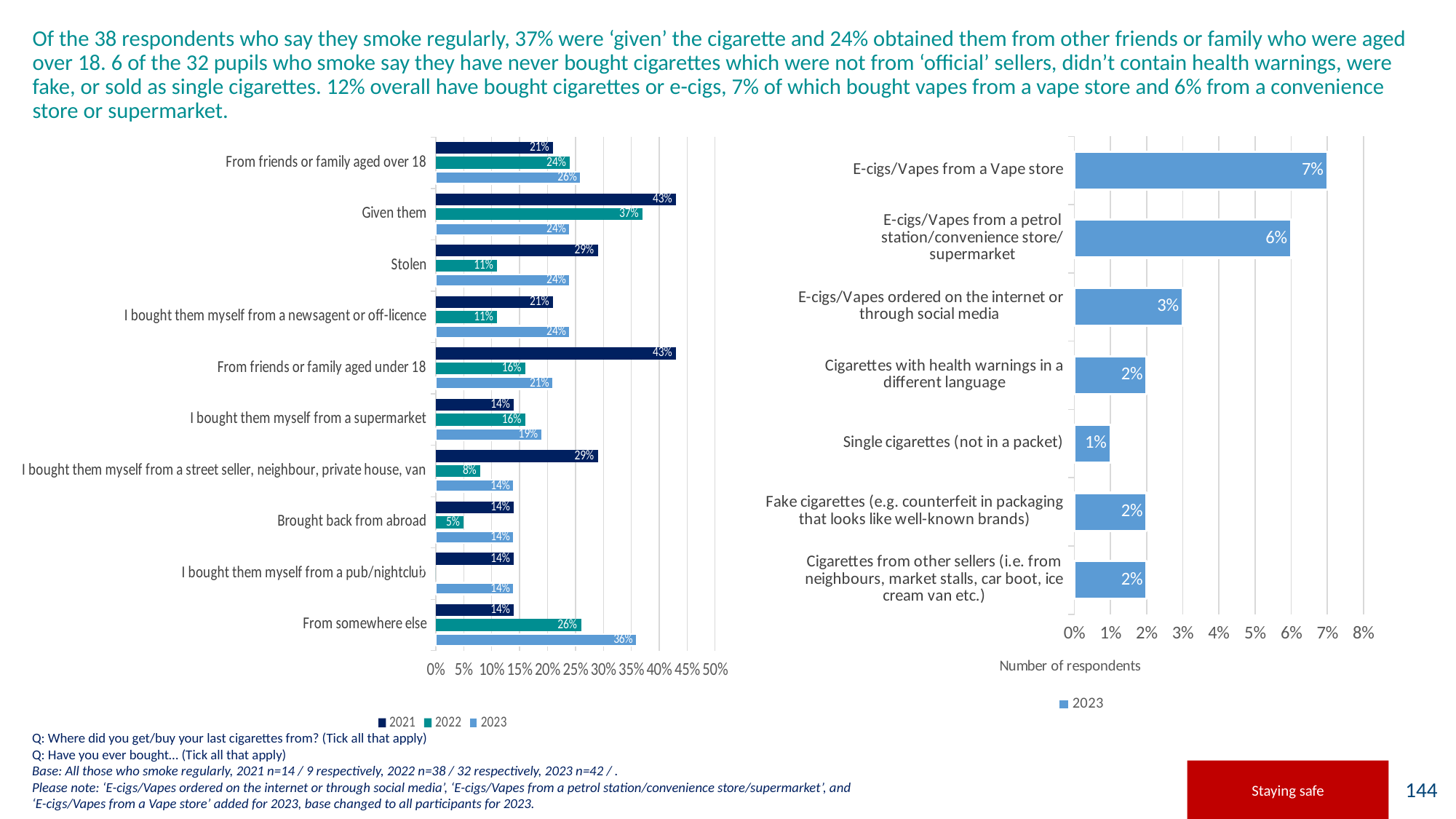
In the right chart, what is the difference between 'E-cigs/Vapes from a Vape store' and 'E-cigs/Vapes ordered on the internet or through social media'? 4% In the left chart, what is the 2022 value for 'Given them'? 37% How many categories are shown in the right chart? 7 In the left chart, what is the 2021 value for 'Stolen'? 29% In the left chart, what is the 2023 value for 'From somewhere else'? 36% What type of chart is the right chart? Bar chart In the left chart, which is larger for 'Stolen': the 2022 value or the 2023 value? 2023 In the right chart, which category has the lowest value? Single cigarettes (not in a packet) How many series does the legend of the left chart list? 3 In the left chart, which category has the highest 2023 value? From somewhere else In the right chart, what is the value for 'E-cigs/Vapes from a Vape store'? 7% In the left chart, what is the difference between the 2021 and 2022 values for 'Brought back from abroad'? 9%